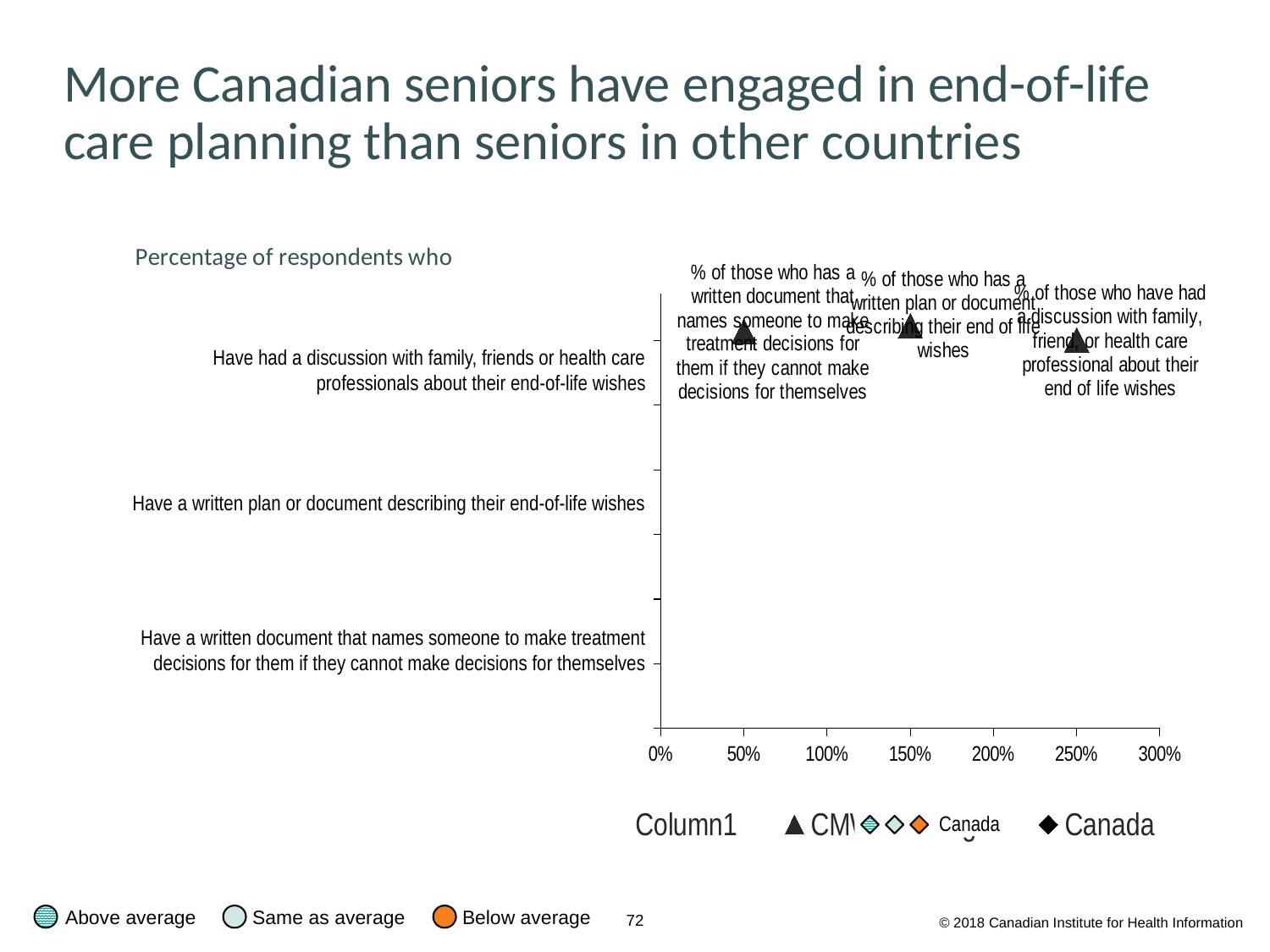
Is the value of the middle triangle marker on the chart greater or less than 100%? greater Is the value of the rightmost triangle marker on the chart greater or less than 200%? greater Which category is listed at the top of the vertical axis of the chart? Have had a discussion with family, friends or health care professionals about their end-of-life wishes Is the value of the leftmost triangle marker on the chart greater or less than 100%? less Which category is listed at the bottom of the vertical axis of the chart? Have a written document that names someone to make treatment decisions for them if they cannot make decisions for themselves What is the highest value shown on the horizontal axis of the chart? 300% What is the interval between tick marks on the horizontal axis of the chart? 50% How many categories are listed on the vertical axis of the chart? 3 How many triangle markers are plotted on the chart? 3